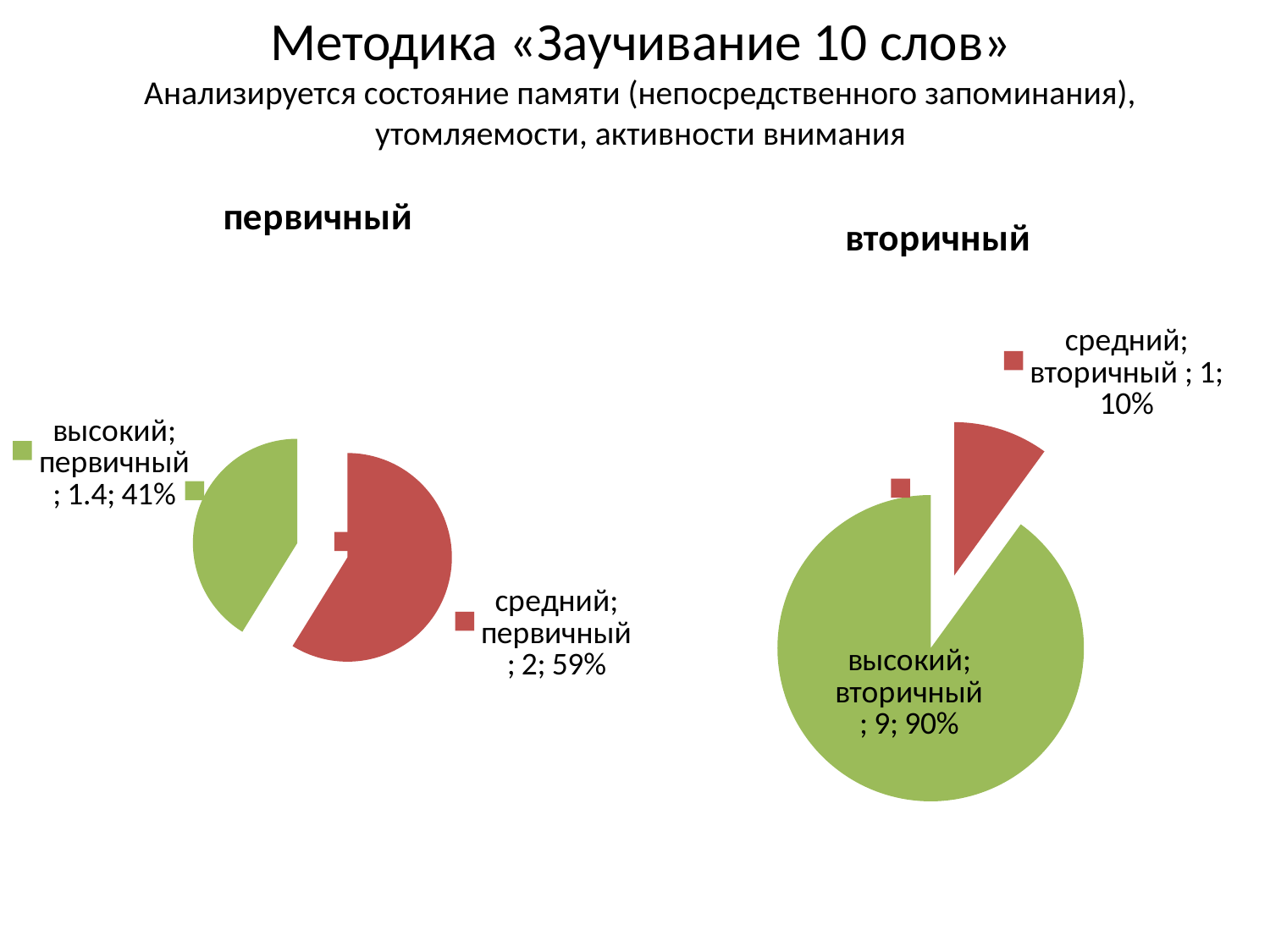
How many slices does the "вторичный" chart have? 2 In the "первичный" chart, what value is shown for "средний"? 2 In the "вторичный" chart, what share of the pie does "высокий" take? 90% What kind of chart is the "первичный" chart on the left? pie chart In the "первичный" chart, what share of the pie does "средний" take? 59% In the "вторичный" chart, which slice is the largest? высокий In the "первичный" chart, which slice is larger, "высокий" or "средний"? средний In the "вторичный" chart, what is the difference between the values for "высокий" and "средний"? 8 In the "вторичный" chart, what value is shown for "высокий"? 9 In the "первичный" chart, what value is shown for "высокий"? 1.4 In the "первичный" chart, what share of the pie does "высокий" take? 41% In the "вторичный" chart, what value is shown for "средний"? 1